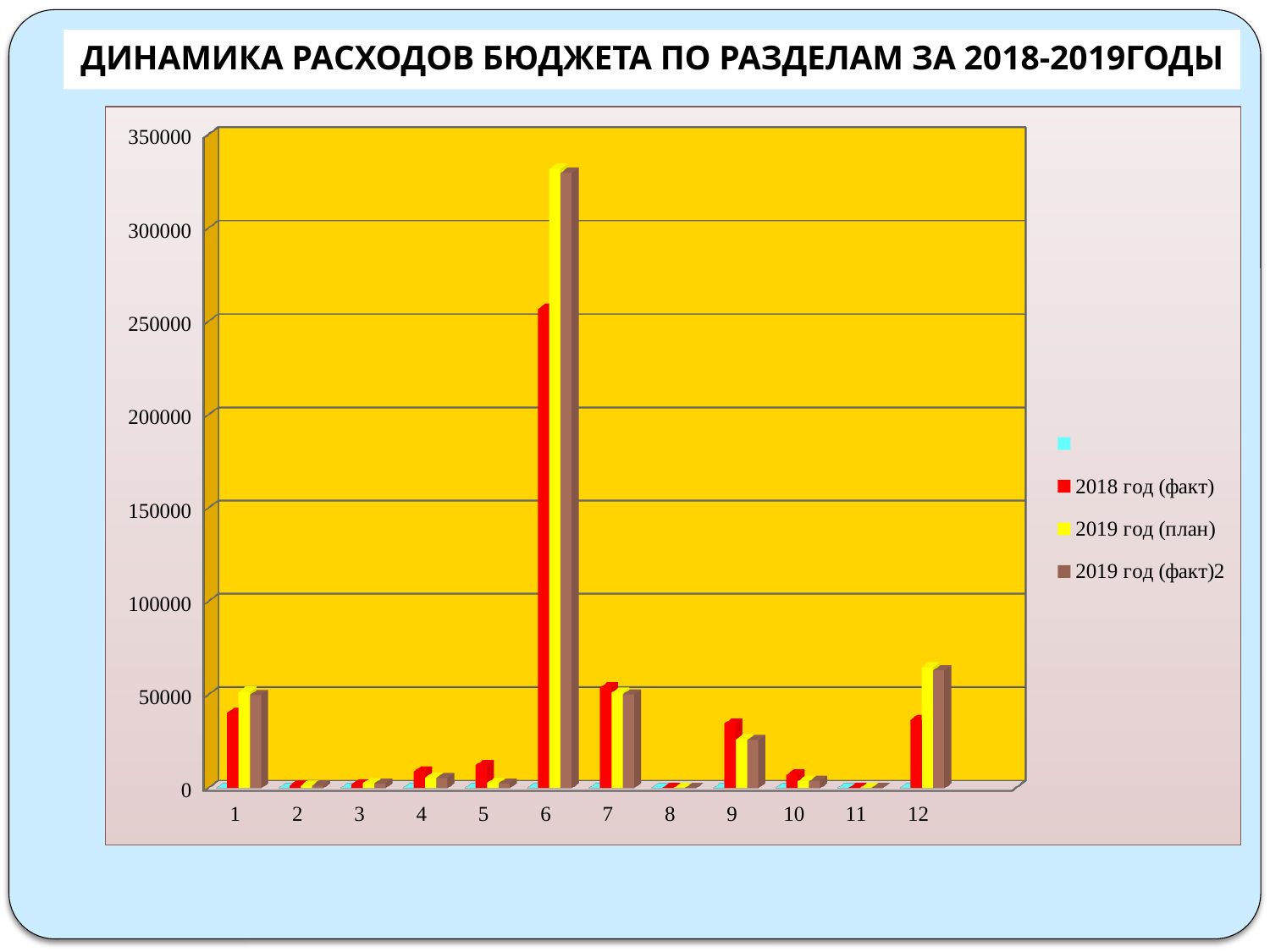
How many labelled series does the legend list? 3 Is the value for category 6 in the 2019 год (план) series greater or less than 300000? greater Is the value for category 9 in the 2018 год (факт) series greater or less than 50000? less Is the value for category 12 in the 2019 год (план) series greater or less than 50000? greater Which category has the highest value for the 2019 год (план) series? 6 Which category has the highest value for the 2018 год (факт) series? 6 How many categories are shown along the x axis? 12 What kind of chart is shown on the slide? bar chart What colour represents the 2018 год (факт) series? red For category 12, which is larger: the 2018 год (факт) value or the 2019 год (план) value? 2019 год (план) For category 9, which is larger: the 2018 год (факт) value or the 2019 год (факт)2 value? 2018 год (факт)